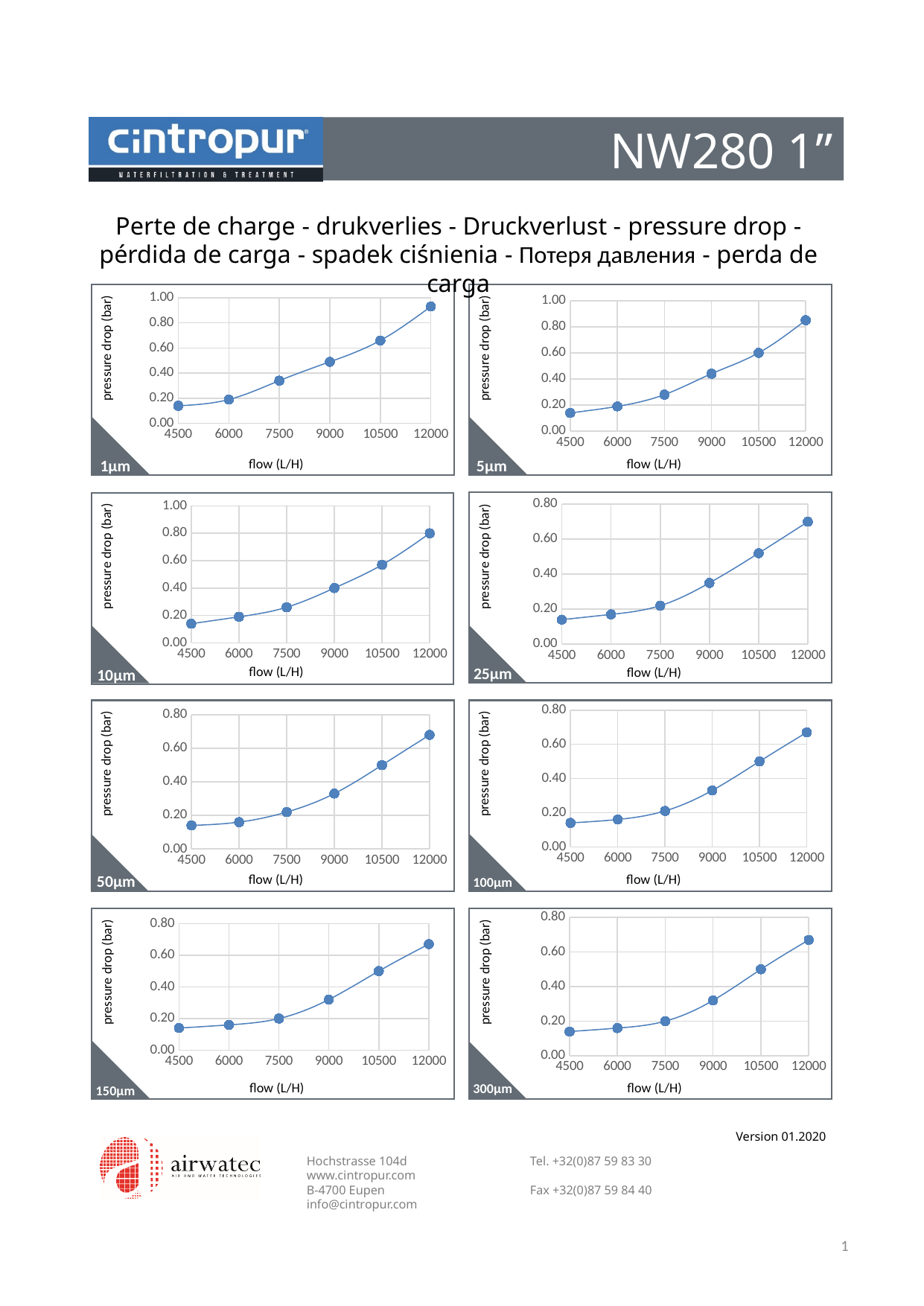
How many data points are plotted on the 5µm chart? 6 How many charts are shown on the slide? 8 On the 300µm chart, is the pressure drop at 6000 L/H greater or less than 0.20? less On the 5µm chart, is the pressure drop at 9000 L/H greater or less than 0.60? less On the 25µm chart, at which flow value is the pressure drop highest? 12000 On the 150µm chart, which has the larger pressure drop: 9000 L/H or 10500 L/H? 10500 L/H On the 1µm chart, does the pressure drop rise or fall as flow increases along the x axis? rise On the 1µm chart, is the pressure drop at 12000 L/H greater or less than 0.80? greater What kind of chart is the 1µm chart? line chart On the 50µm chart, at which flow value is the pressure drop lowest? 4500 What is the x-axis label on the 10µm chart? flow (L/H)